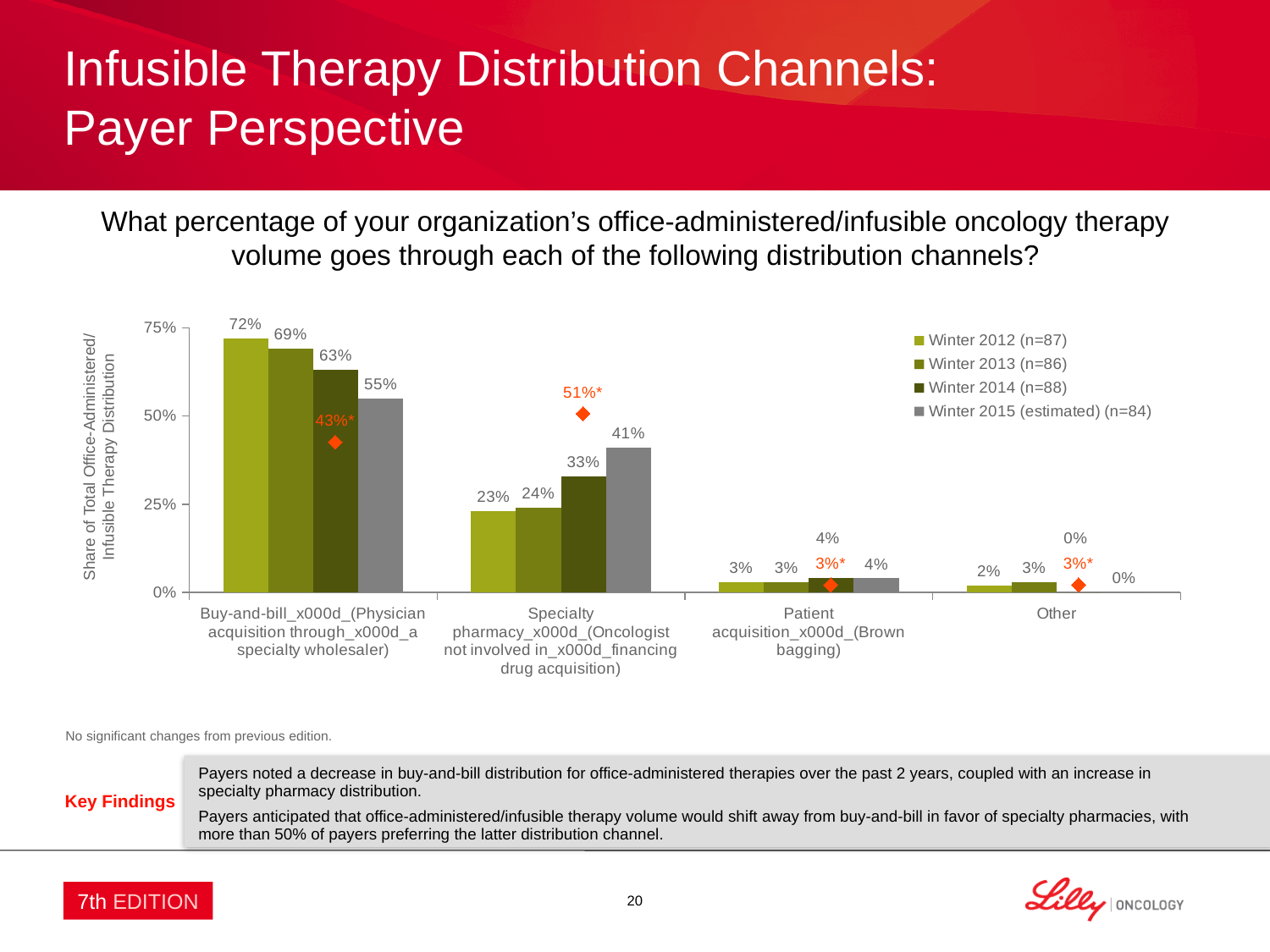
Which distribution channel has the lowest Winter 2015 (estimated) (n=84) value? Other Which is larger for Specialty pharmacy: the Winter 2013 (n=86) value or the Winter 2014 (n=88) value? Winter 2014 (n=88) How many distribution channel categories are shown on the x axis? 4 What is the Winter 2014 (n=88) value for Patient acquisition (Brown bagging)? 4% What is the difference between the Winter 2012 (n=87) and Winter 2015 (estimated) (n=84) values for Buy-and-bill? 17% What is the Winter 2012 (n=87) value for Buy-and-bill (Physician acquisition through a specialty wholesaler)? 72% Which distribution channel has the highest Winter 2012 (n=87) value? Buy-and-bill (Physician acquisition through a specialty wholesaler) What kind of chart is shown on the slide? Bar chart Do the Specialty pharmacy values rise or fall from Winter 2012 to Winter 2015 (estimated)? Rise What is the Winter 2015 (estimated) (n=84) value for Specialty pharmacy (Oncologist not involved in financing drug acquisition)? 41% How many series does the legend list? 4 What is the Winter 2013 (n=86) value for Other? 3%